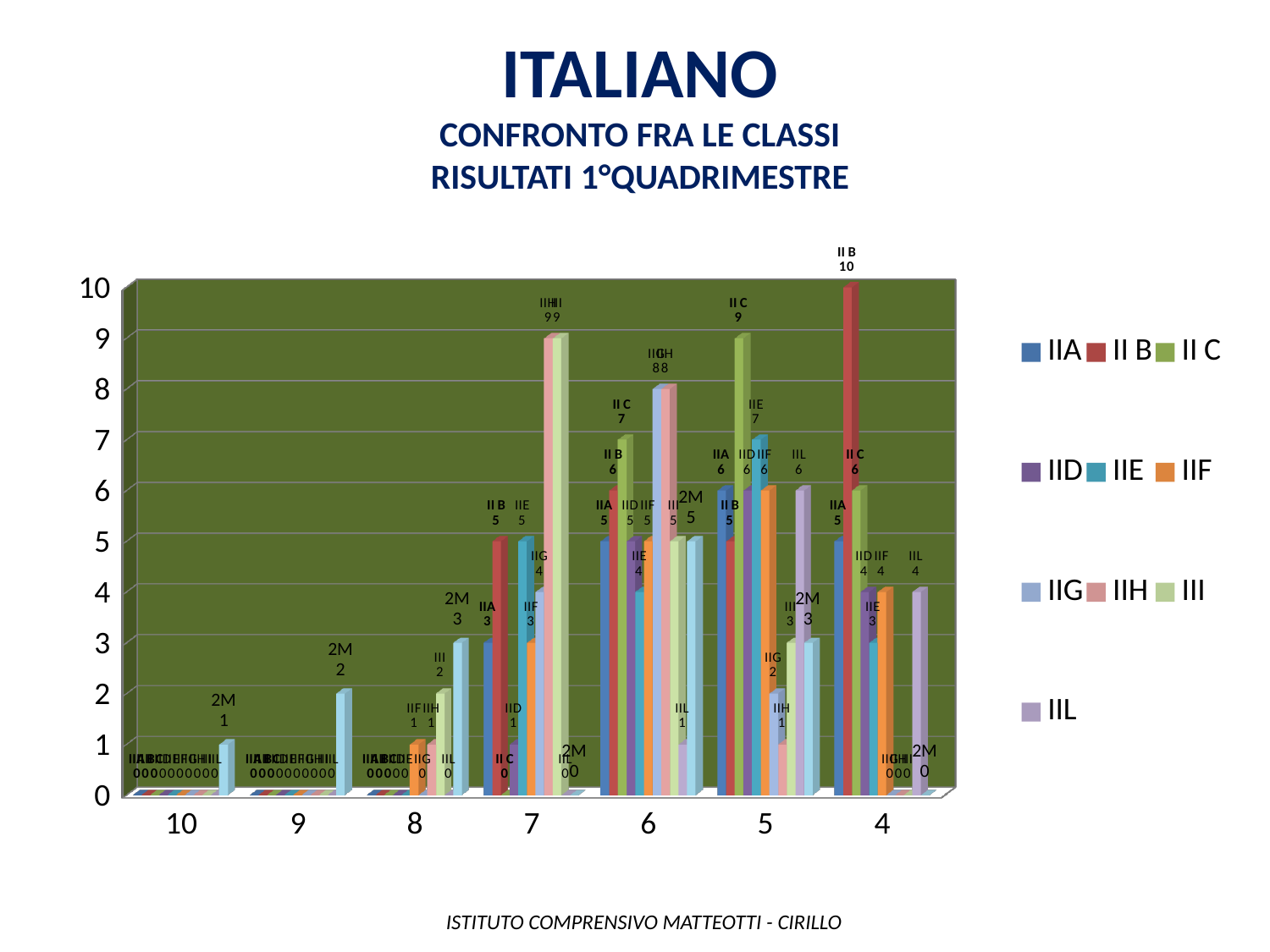
What kind of chart is shown on the slide? bar chart What is the main title of the chart slide? ITALIANO Which class has the highest bar at grade 4? II B At grade 6, which is larger, II C or II B? II C What is the value for IIE at grade 5? 7 What is the difference between II C and IIA at grade 5? 3 How many series does the legend list? 10 What is the value for II B at grade 4? 10 What is the value for IIE at grade 4? 3 What is the value for IIL at grade 5? 6 How many grade categories are shown on the x axis? 7 What is the value for II C at grade 5? 9